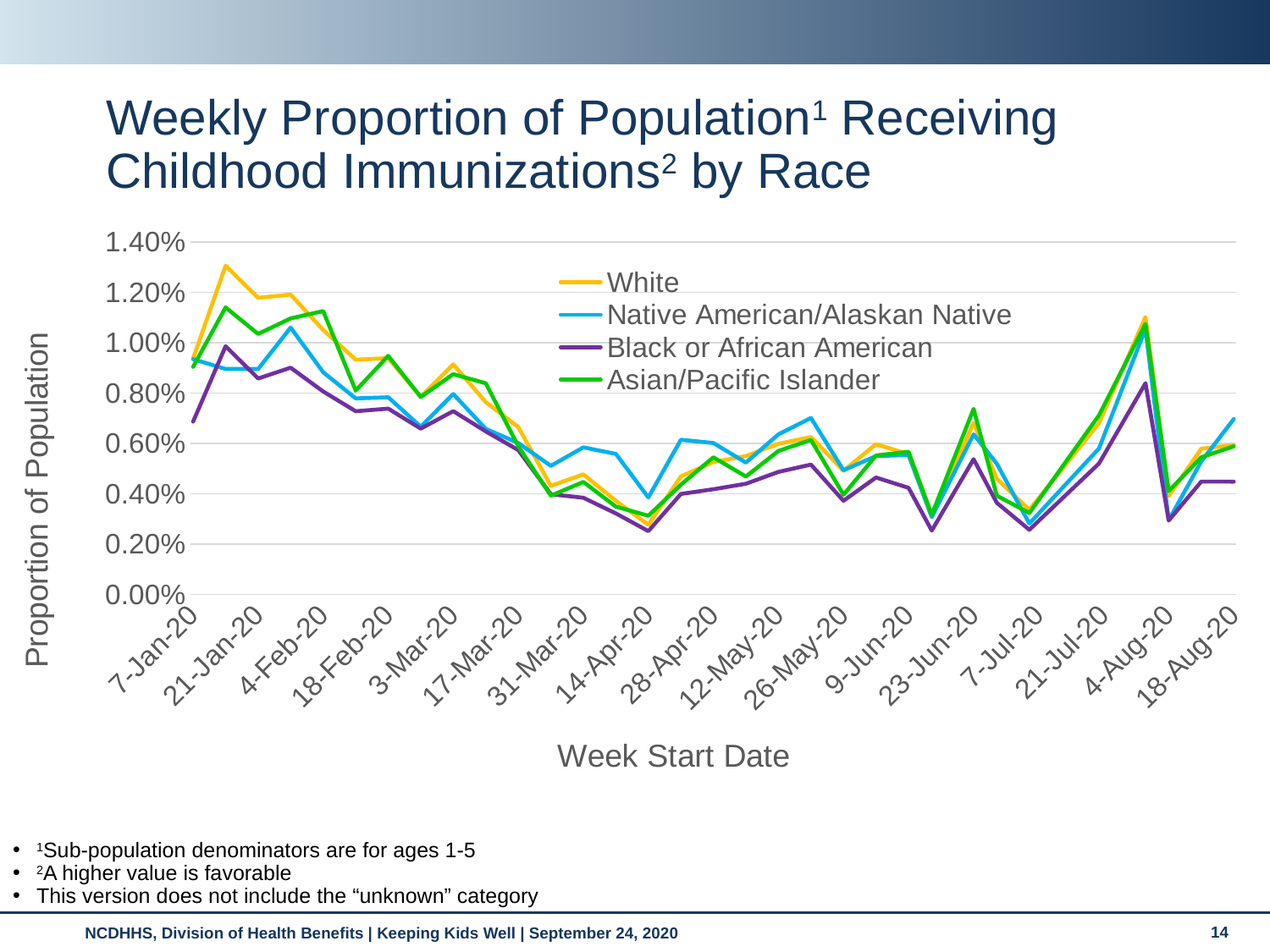
Does the White series rise or fall between 21-Jan-20 and 14-Apr-20? fall How many series does the legend list? 4 What is the title of the chart? Weekly Proportion of Population Receiving Childhood Immunizations by Race Is the value for Black or African American at 14-Apr-20 greater or less than 0.40%? less At 21-Jan-20, which is larger: the value for White or the value for Black or African American? White Which series reaches the highest value anywhere on the chart? White What kind of chart is shown on the slide? Line chart What is the label of the x axis? Week Start Date At 18-Aug-20, which is larger: the value for Native American/Alaskan Native or the value for Black or African American? Native American/Alaskan Native Is the value for Asian/Pacific Islander at 23-Jun-20 greater or less than 0.60%? greater How many week start dates are labeled on the x axis? 17